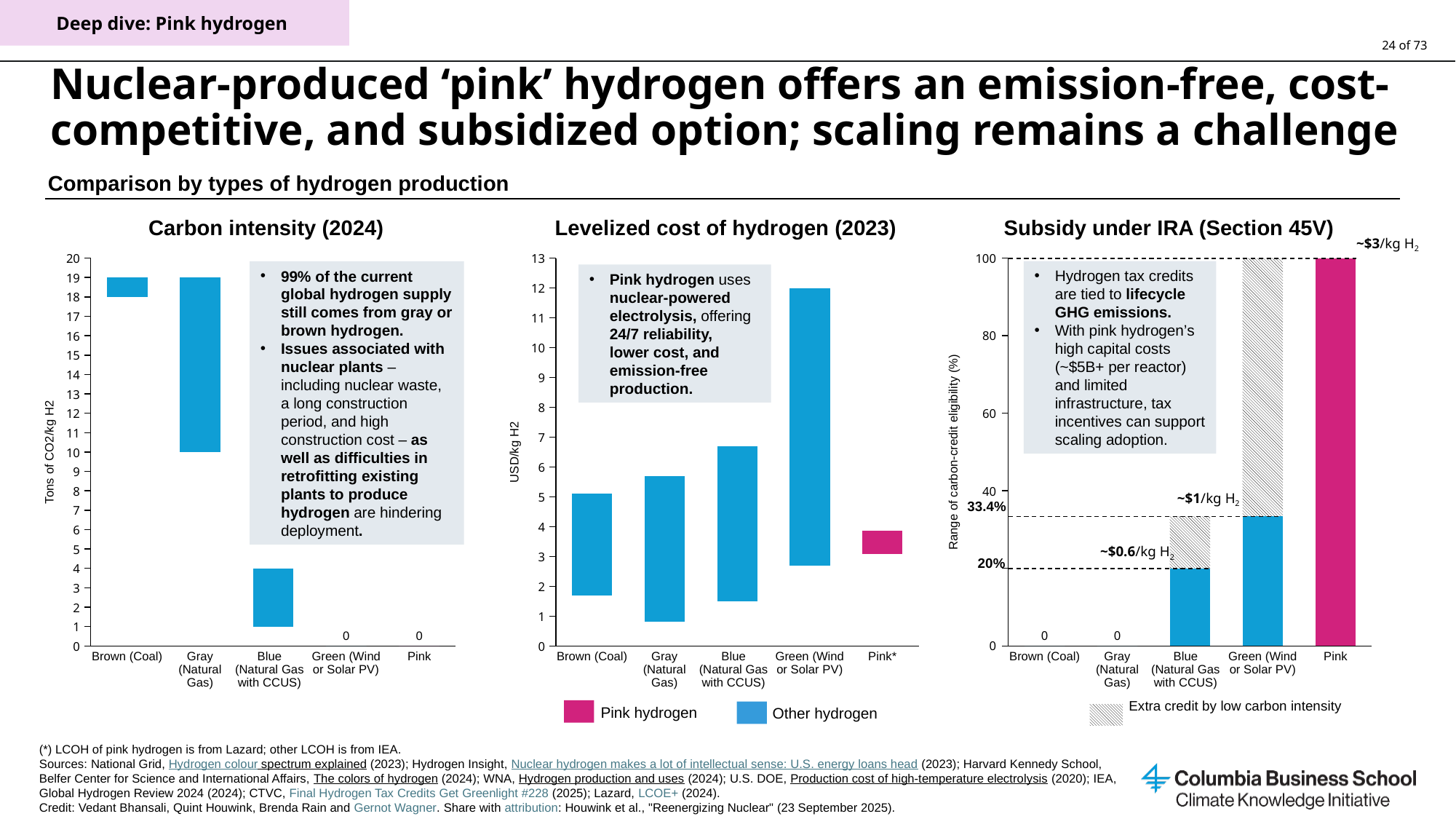
What kind of chart is the Carbon intensity (2024) chart? bar chart In the Levelized cost of hydrogen (2023) chart, is the top of the bar for Green (Wind or Solar PV) greater or less than 10? greater In the Subsidy under IRA (Section 45V) chart, what is the carbon-credit eligibility value for Green (Wind or Solar PV)? 33.4% In the Carbon intensity (2024) chart, what is the value for Green (Wind or Solar PV)? 0 How many series does the legend of the Levelized cost of hydrogen (2023) chart list? 2 In the Subsidy under IRA (Section 45V) chart, what is the difference between the eligibility values for Green (Wind or Solar PV) and Blue (Natural Gas with CCUS)? 13.4 percentage points In the Subsidy under IRA (Section 45V) chart, what is the carbon-credit eligibility value for Blue (Natural Gas with CCUS)? 20% In the Subsidy under IRA (Section 45V) chart, which hydrogen type has the highest carbon-credit eligibility? Pink In the Carbon intensity (2024) chart, is the top of the bar for Blue (Natural Gas with CCUS) greater or less than 5? less In the Levelized cost of hydrogen (2023) chart, is the top of the bar for Pink* greater or less than 5? less In the Subsidy under IRA (Section 45V) chart, what does the hatched pattern in the legend represent? Extra credit by low carbon intensity In the Carbon intensity (2024) chart, how many hydrogen production types are shown on the x axis? 5